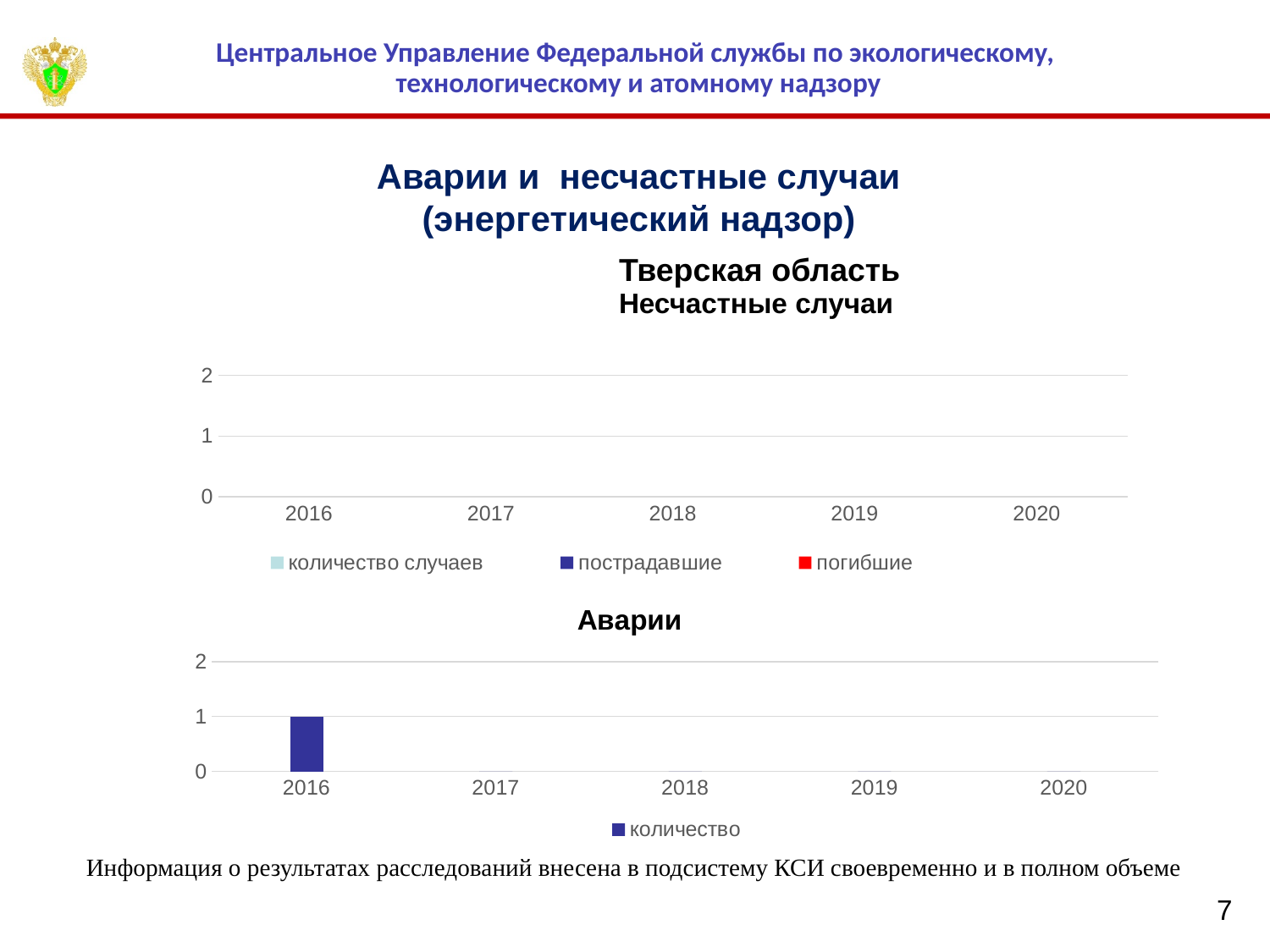
In the 'Несчастные случаи' chart, how many series does the legend list? 3 In the 'Несчастные случаи' chart, what is the first year shown on the x axis? 2016 In the 'Аварии' chart, is the value for 2016 greater or less than 2? less In the 'Аварии' chart, what is the value for 2016? 1 In the 'Несчастные случаи' chart, how many years are shown on the x axis? 5 In the 'Аварии' chart, what kind of chart is it? bar chart In the 'Аварии' chart, how many series does the legend list? 1 In the 'Аварии' chart, how many years are shown on the x axis? 5 In the 'Аварии' chart, which year has the highest value? 2016 In the 'Аварии' chart, what is the name of the series in the legend? количество In the 'Несчастные случаи' chart, what is the highest value shown on the y axis? 2